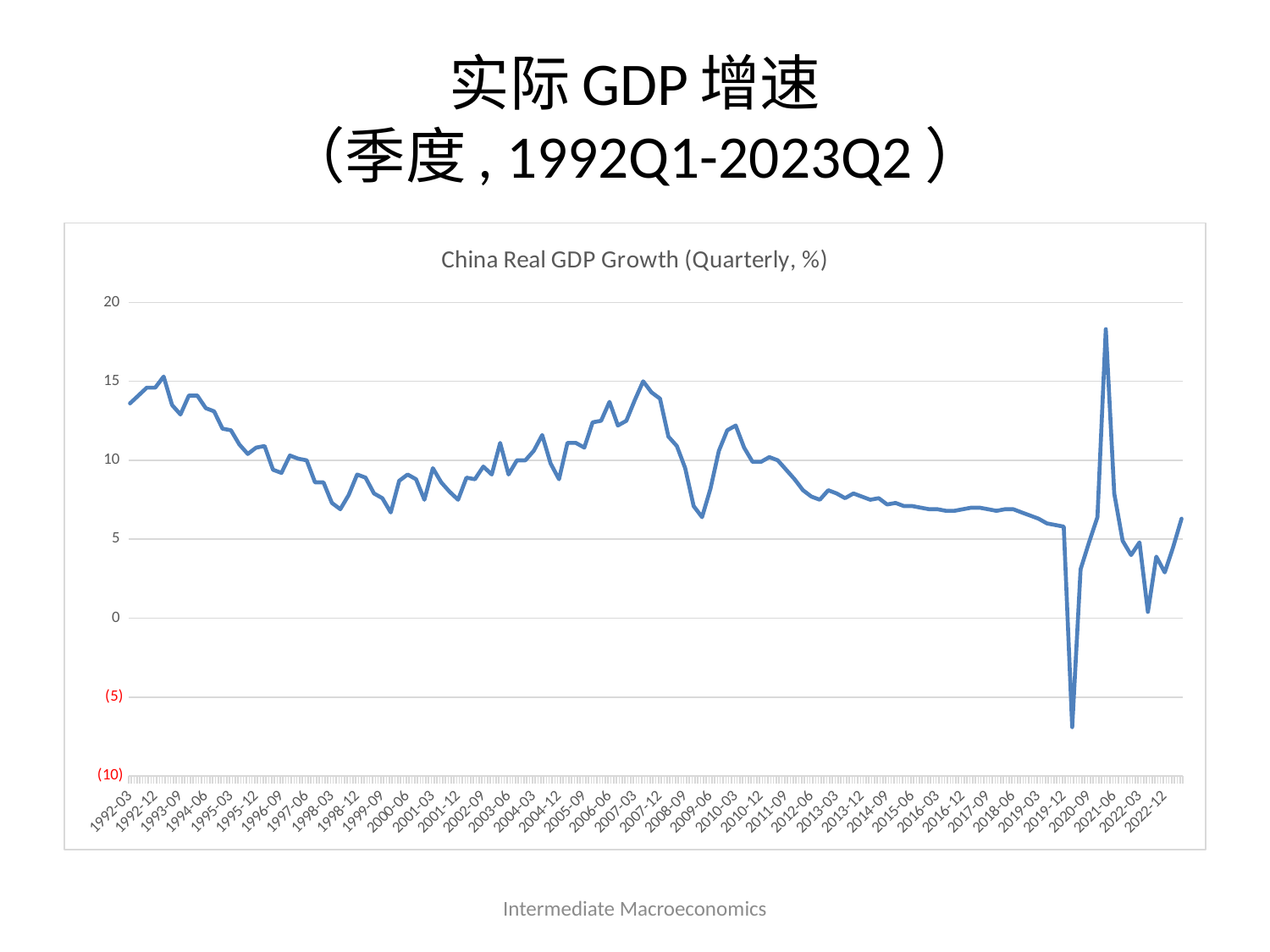
Between 2010-03 and 2019-12, do the values generally rise or fall? fall Is the highest point of the line, in 2021, greater or less than 15? greater In which year does the line reach its highest point? 2021 What is the lowest tick label shown on the vertical axis? (10) Is the lowest point of the line, in 2020, greater or less than 0? less Is the value for 1992-03 greater or less than 10? greater Which is larger, the value for 1992-03 or the value for 2016-03? 1992-03 What is the title printed inside the chart area? China Real GDP Growth (Quarterly, %) In which year does the line reach its lowest point? 2020 What kind of chart is shown on the slide? line chart